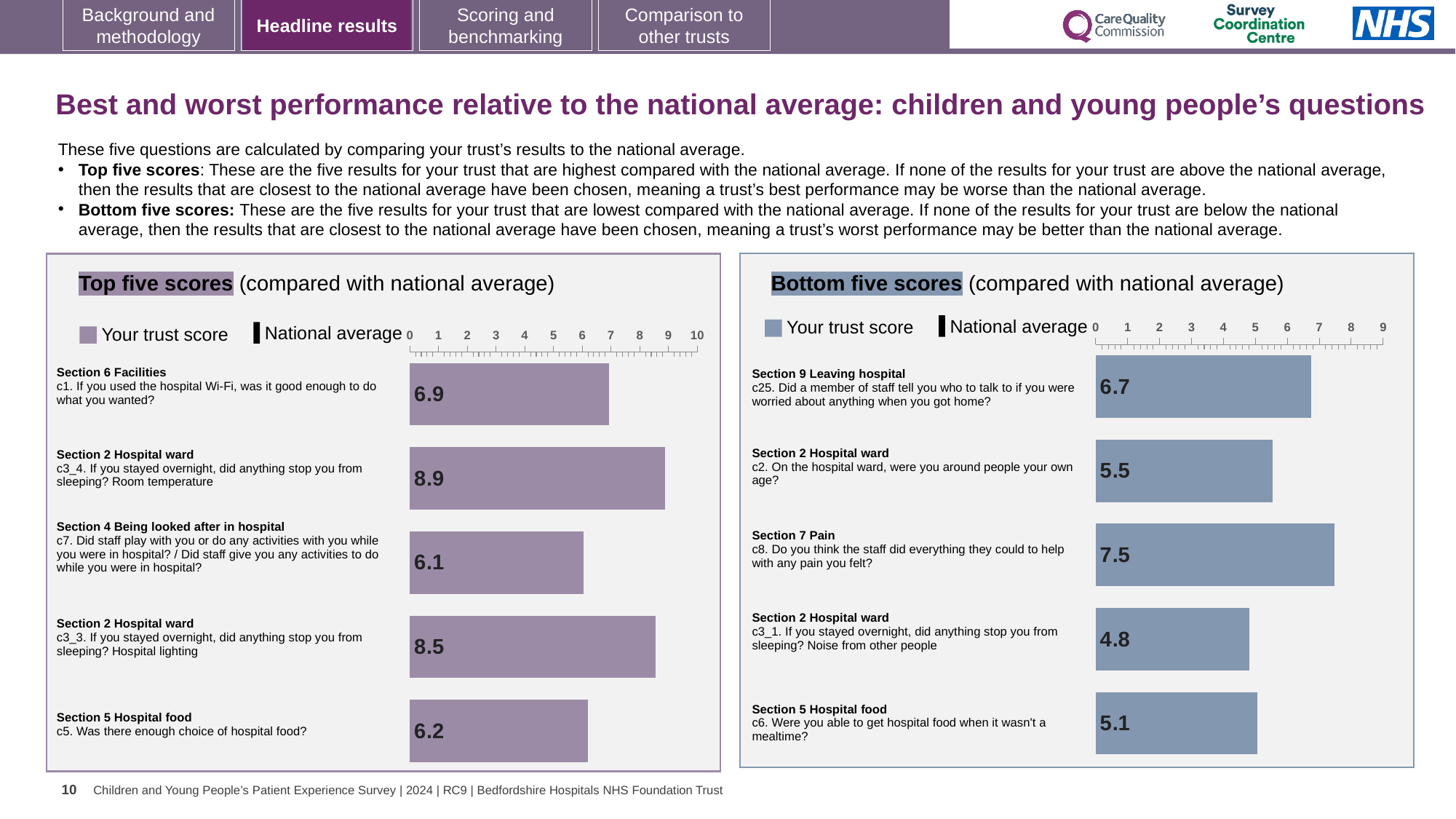
In the Top five scores chart, which question has the lowest trust score? c7 (Did staff play with you or do any activities with you), 6.1 What kind of chart is the Bottom five scores chart? Bar chart How many questions are plotted in the Top five scores chart? 5 In the Bottom five scores chart, what is the trust score for c8 (did the staff do everything they could to help with any pain you felt)? 7.5 In the Top five scores chart, what is the trust score for c5 (was there enough choice of hospital food)? 6.2 In the Bottom five scores chart, which question has the lowest trust score? c3_1 (Noise from other people), 4.8 In the Bottom five scores chart, which has the larger trust score: c25 (told who to talk to if worried when you got home) or c2 (around people your own age)? c25, 6.7 In the Bottom five scores chart, what is the difference between the trust scores for c8 (Pain) and c3_1 (Noise from other people)? 2.7 In the Top five scores chart, what is the difference between the trust scores for c3_4 (Room temperature) and c7 (staff play/activities)? 2.8 In the Bottom five scores chart, which question has the highest trust score? c8 (Pain), 7.5 In the Top five scores chart, what is the trust score for c3_4 (did anything stop you from sleeping? Room temperature)? 8.9 In the Top five scores chart, which question has the highest trust score? c3_4 (Room temperature), 8.9